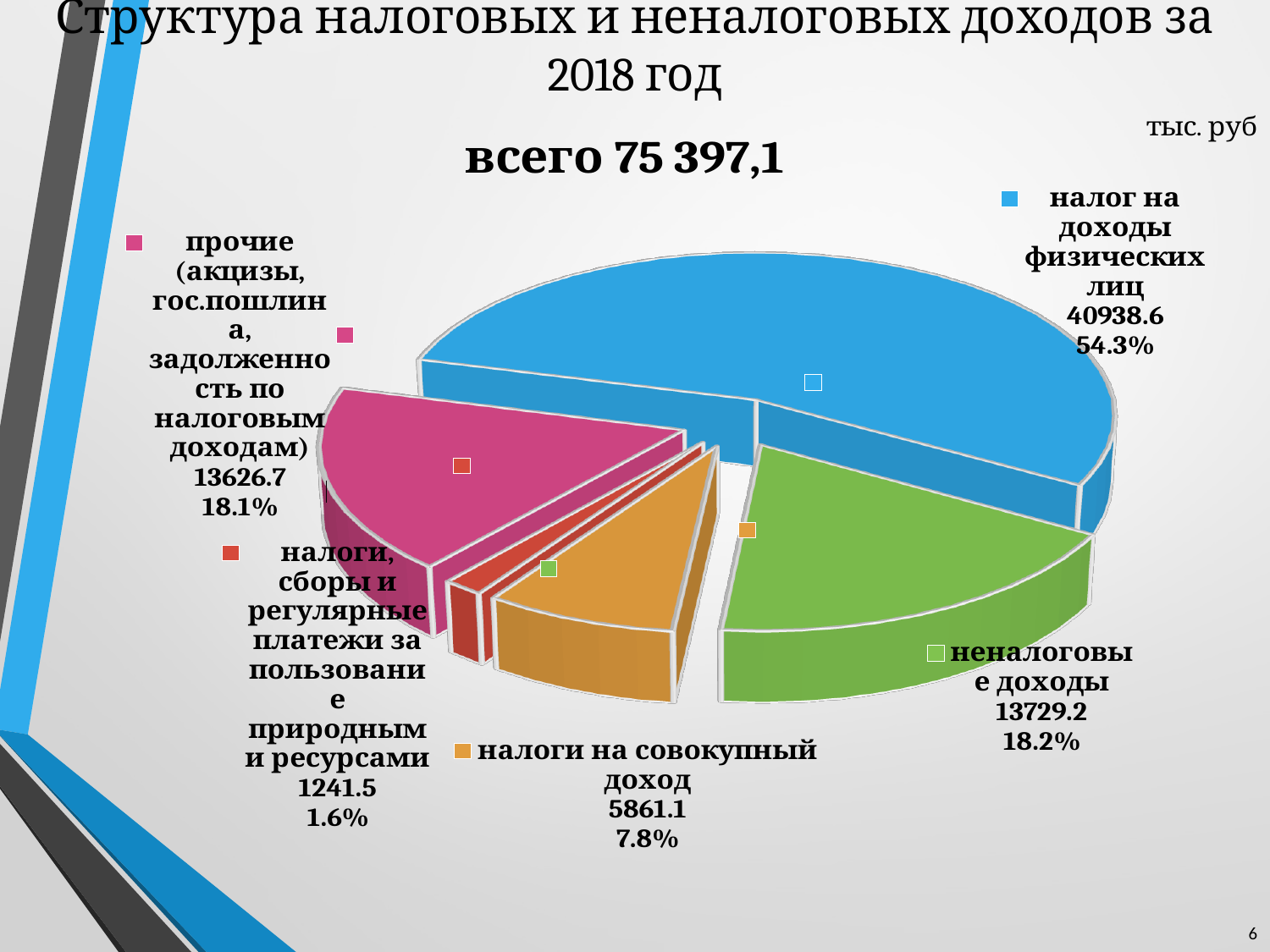
What kind of chart is shown on the slide? pie chart What is the value for неналоговые доходы? 13729.2 What is the value for налог на доходы физических лиц? 40938.6 What share of the pie does налог на доходы физических лиц take? 54.3% Which category has the largest slice of the pie? налог на доходы физических лиц What share of the pie does прочие (акцизы, гос.пошлина, задолженность по налоговым доходам) take? 18.1% Which category has the smallest slice of the pie? налоги, сборы и регулярные платежи за пользование природными ресурсами What share of the pie does налоги на совокупный доход take? 7.8% What is the value for налоги, сборы и регулярные платежи за пользование природными ресурсами? 1241.5 How many slices does the pie chart have? 5 What is the difference between the values for налог на доходы физических лиц and неналоговые доходы? 27209.4 What total is stated above the pie chart? всего 75 397,1